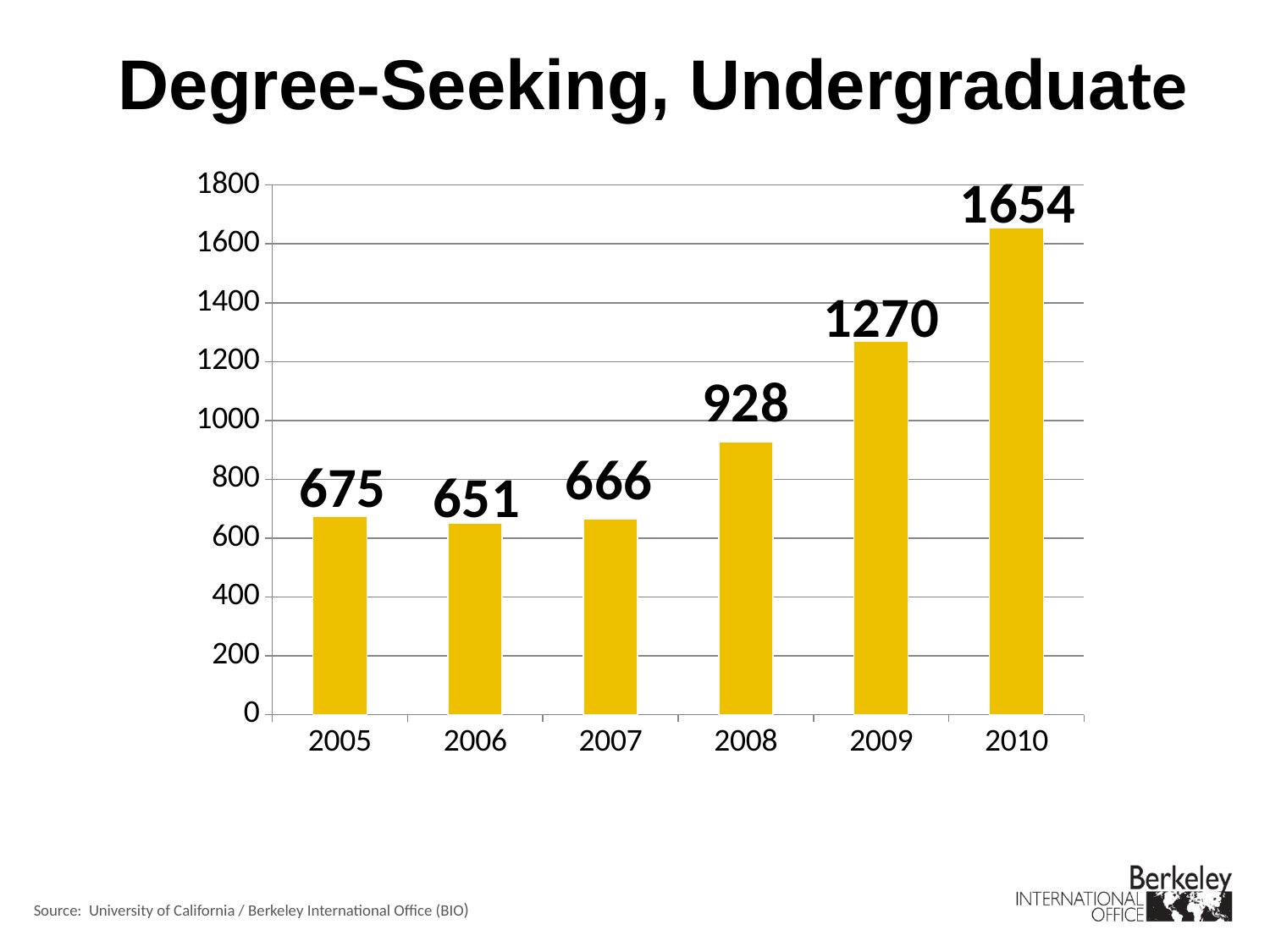
What is the value for 2005? 675 What is the value for 2010? 1654 Is the value for 2009 greater or less than 1200? greater What is the value for 2008? 928 What is the difference between the values for 2010 and 2009? 384 Which is larger, the value for 2005 or the value for 2007? 2005 What kind of chart is shown on the slide? bar chart Which year has the lowest value? 2006 Which year has the highest value? 2010 Do the values rise or fall from 2007 to 2010? rise How many years are shown on the x axis? 6 What is the difference between the values for 2008 and 2007? 262